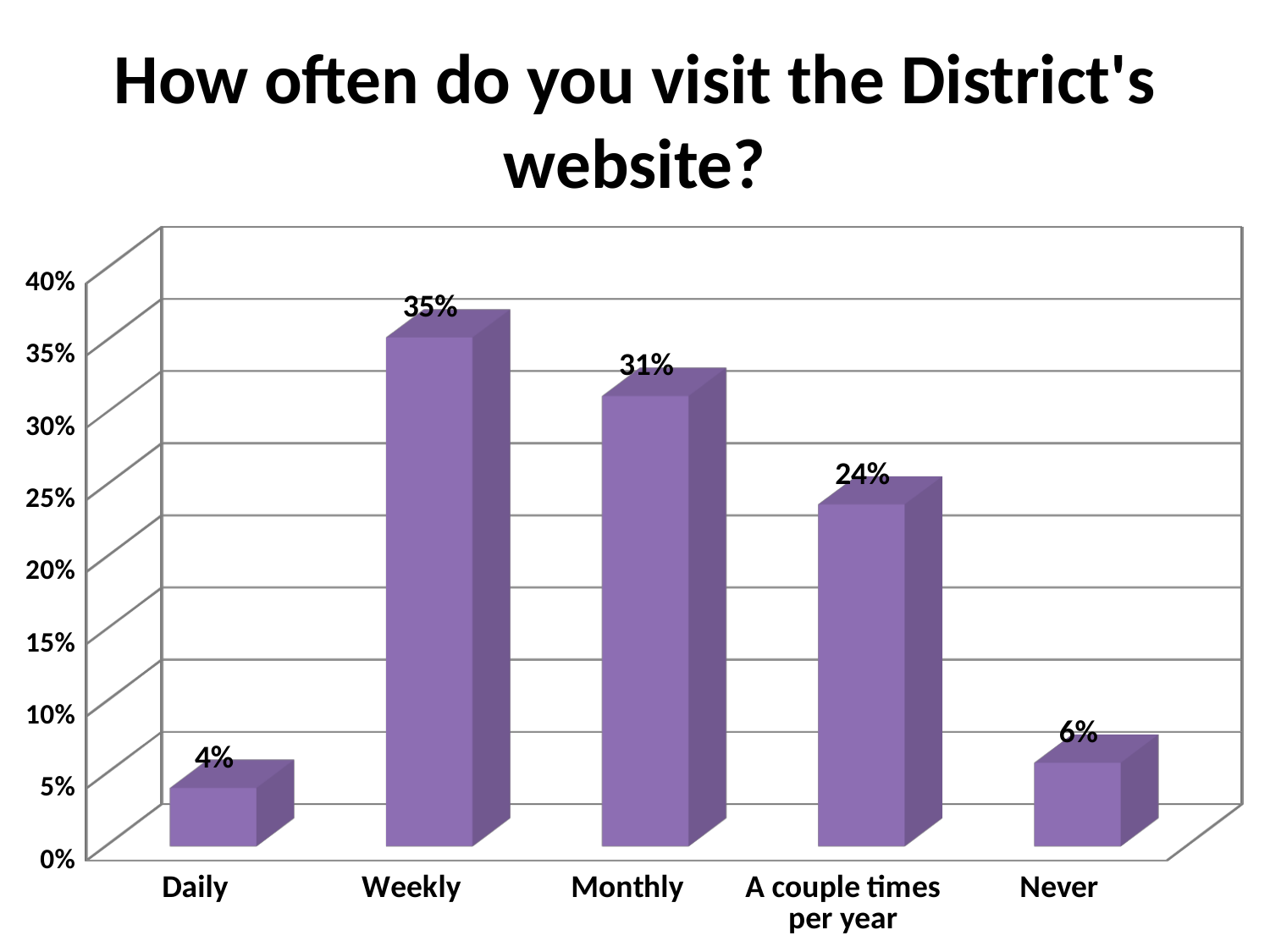
What is the value shown for the 'Daily' category? 4% What is the title of the chart? How often do you visit the District's website? What kind of chart is shown on the slide? bar chart What is the difference between the 'Never' and 'Daily' values? 2% Is the value for 'Never' greater or less than 10%? less Which category has the lowest value? Daily What percentage of respondents visit the website a couple times per year? 24% Which is larger, the value for 'Monthly' or the value for 'A couple times per year'? Monthly Which category has the highest value? Weekly How many categories are shown on the x axis? 5 What percentage of respondents visit the District's website weekly? 35% What is the difference between the 'Weekly' and 'Monthly' values? 4%